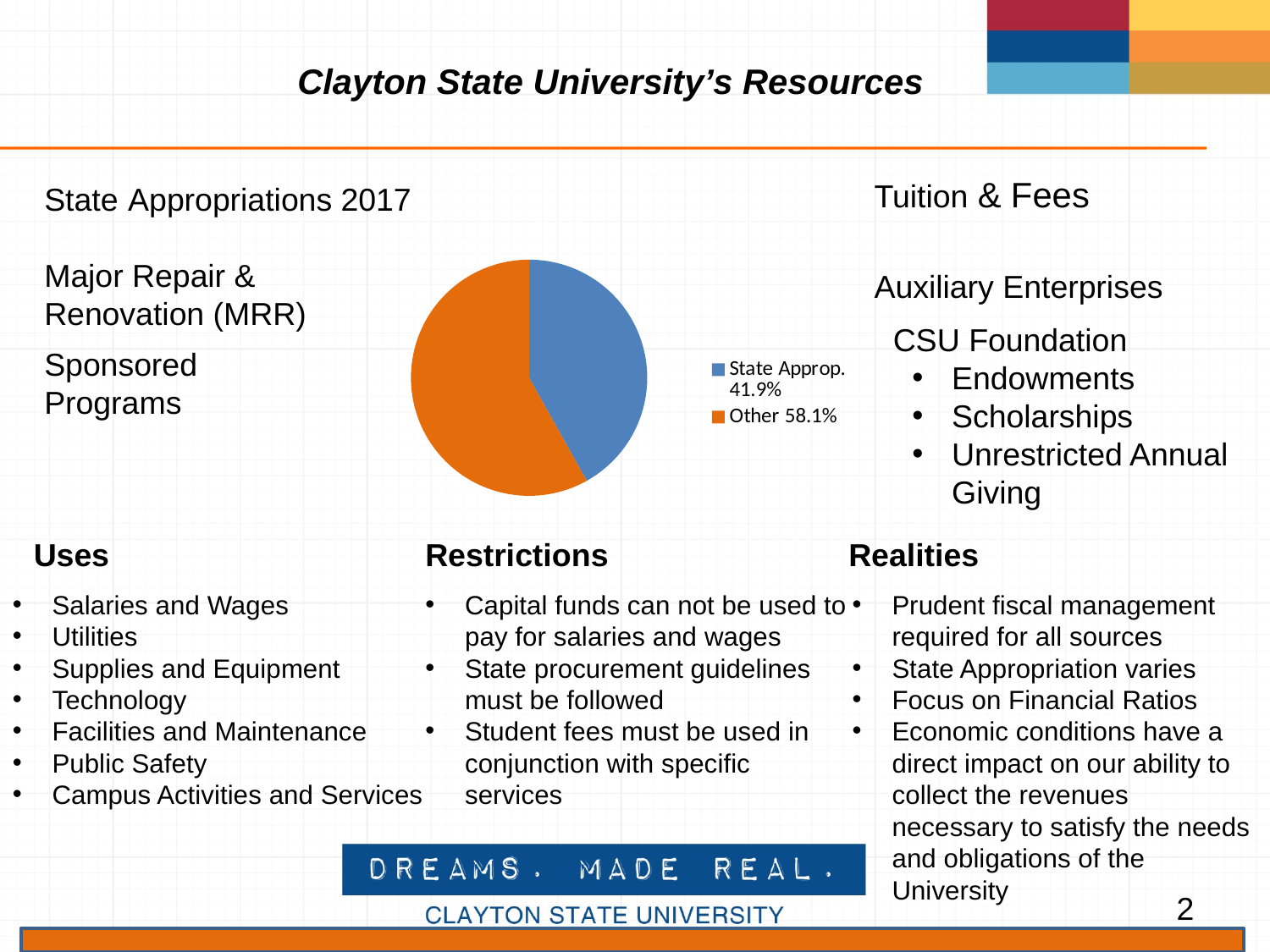
Which is larger, the State Approp. slice or the Other slice? Other Which slice of the pie is the smallest? State Approp. What kind of chart is shown on the slide? pie chart How many slices does the pie chart have? 2 Is the State Approp. share of the pie greater or less than 50%? less How many entries does the pie chart's legend list? 2 What share of the pie does Other represent? 58.1% What is the difference in percentage points between the Other slice and the State Approp. slice? 16.2 What colour is the State Approp. slice in the pie chart? blue Which slice of the pie is the largest? Other What share of the pie does State Approp. represent? 41.9% What colour is the Other slice in the pie chart? orange